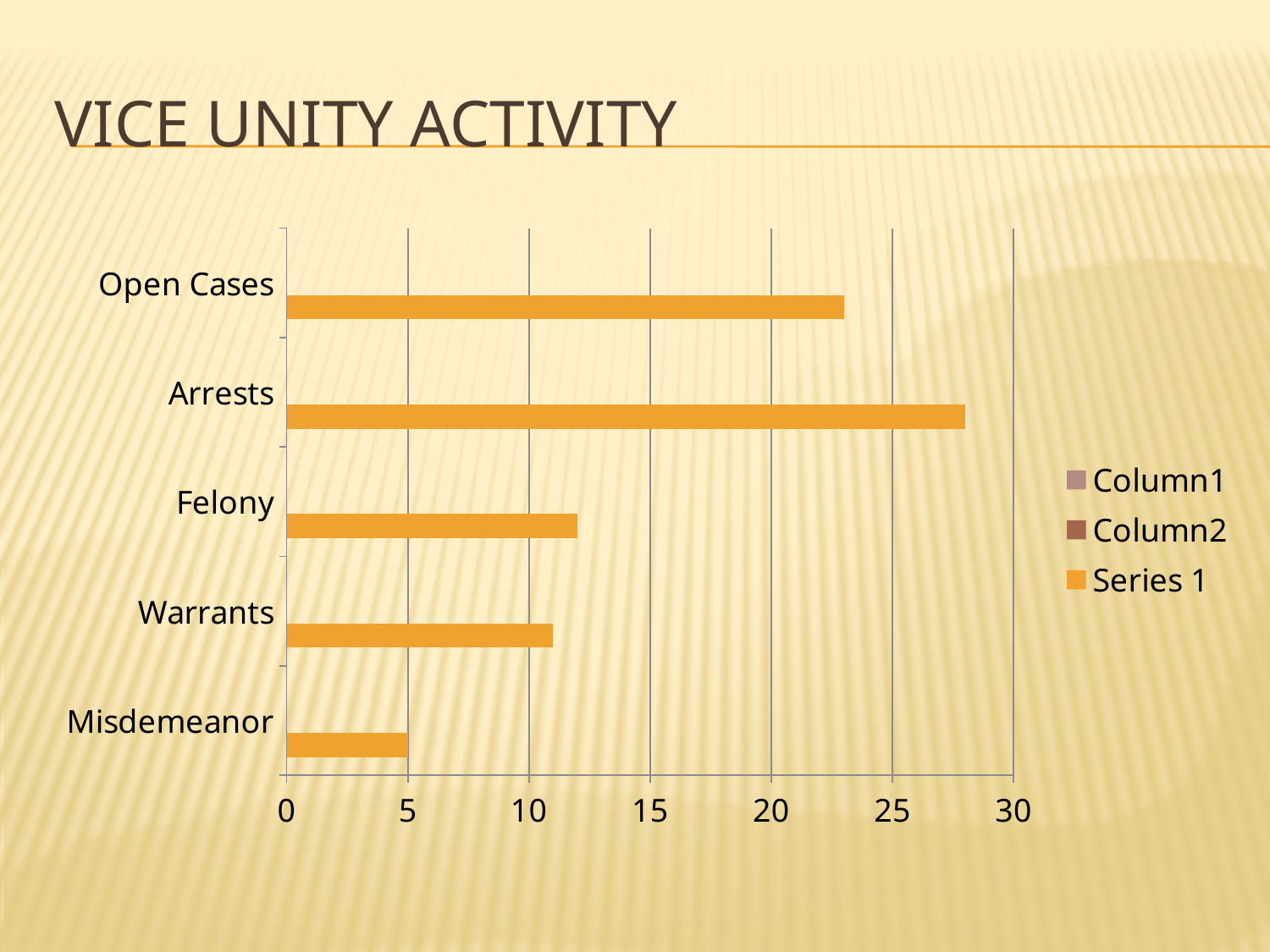
Which category has the highest value? Arrests How many series does the legend list? 3 Is the value for Felony greater or less than 15? less Which legend entry corresponds to the orange bars? Series 1 What is the title of the chart? Vice Unity Activity How many categories are plotted on the chart? 5 What is the value for Misdemeanor? 5 What kind of chart is shown on the slide? bar chart Which is larger, the value for Open Cases or the value for Felony? Open Cases Is the value for Open Cases greater or less than 20? greater Which category has the lowest value? Misdemeanor Is the value for Arrests greater or less than 25? greater